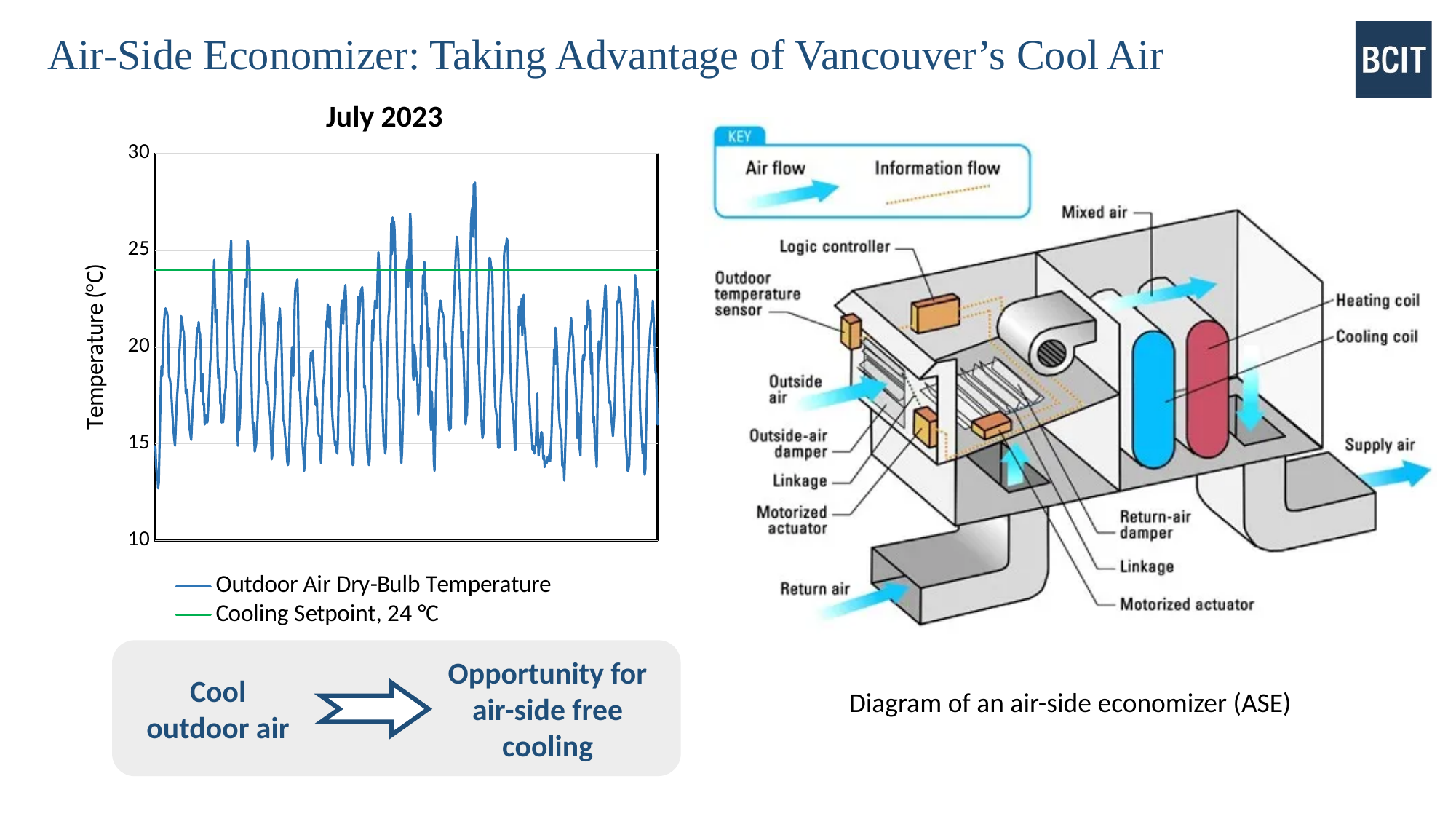
Is the lowest point of the Outdoor Air Dry-Bulb Temperature in the "July 2023" chart greater or less than 15? less How many series does the legend of the "July 2023" chart list? 2 Is the highest peak of the Outdoor Air Dry-Bulb Temperature in the "July 2023" chart greater or less than 30? less What is the value of the Cooling Setpoint series in the "July 2023" chart? 24 °C What is the highest tick value shown on the vertical axis of the "July 2023" chart? 30 Which series in the "July 2023" chart is drawn in blue? Outdoor Air Dry-Bulb Temperature Is the Cooling Setpoint line in the "July 2023" chart greater or less than 25? less What is the label of the vertical axis in the "July 2023" chart? Temperature (°C) What kind of chart is shown under the title "July 2023"? line chart